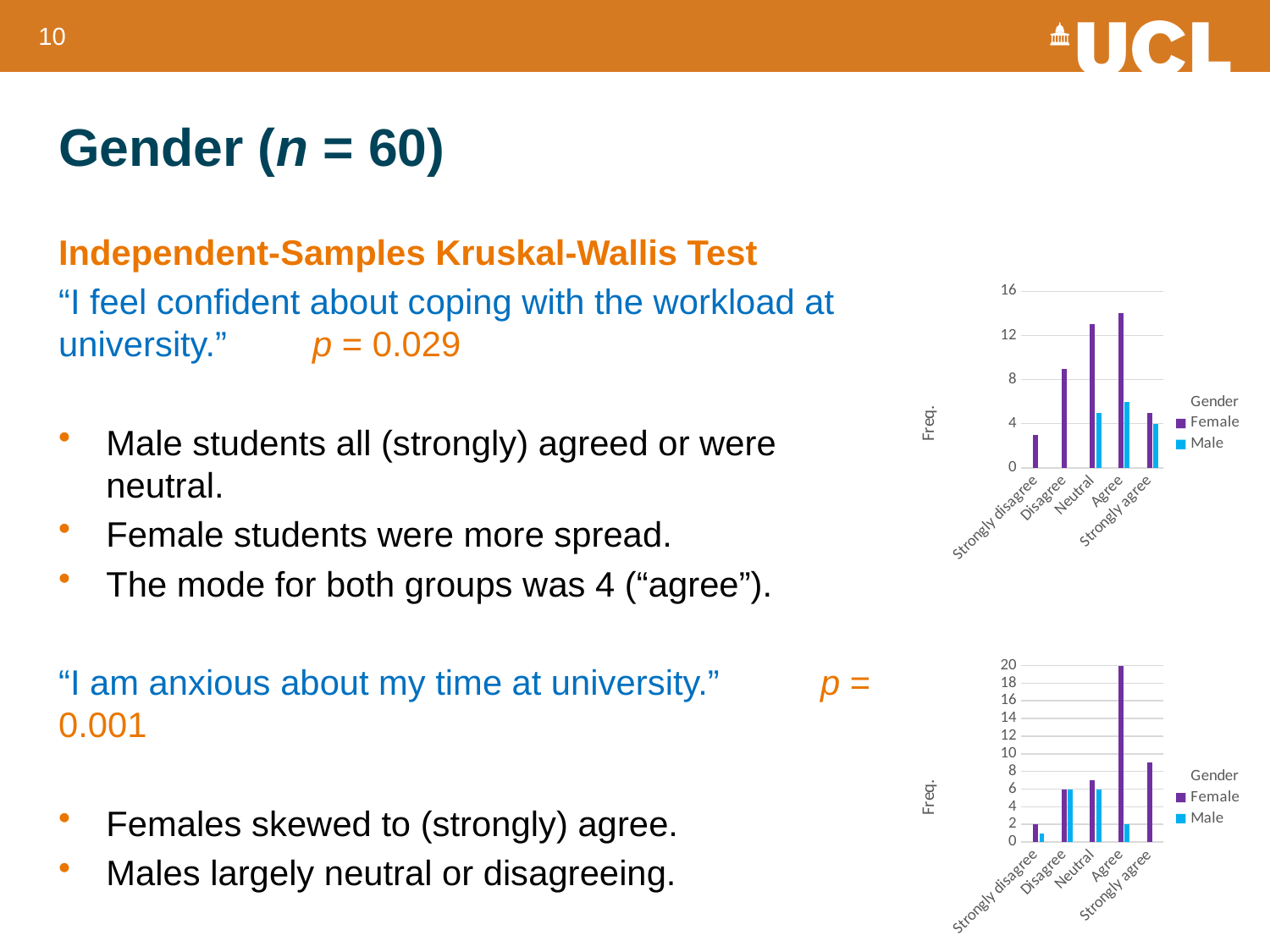
In the bottom chart, which is larger for Strongly agree: the Female value or the Male value? Female In the top chart, is the Male value for Agree greater or less than 8? less In the top chart, which is larger for Disagree: the Female value or the Male value? Female In the bottom chart, which category has the highest Female value? Agree How many series does the legend of the top chart list? 2 How many categories are shown on the x axis of the bottom chart? 5 In the top chart, which category has the highest Female value? Agree What kind of chart is the top chart on the right of the slide? bar chart In the bottom chart, is the Female value for Strongly agree greater or less than 14? less What is the title of the legend in the bottom chart? Gender In the top chart, is the Female value for Neutral greater or less than 12? greater